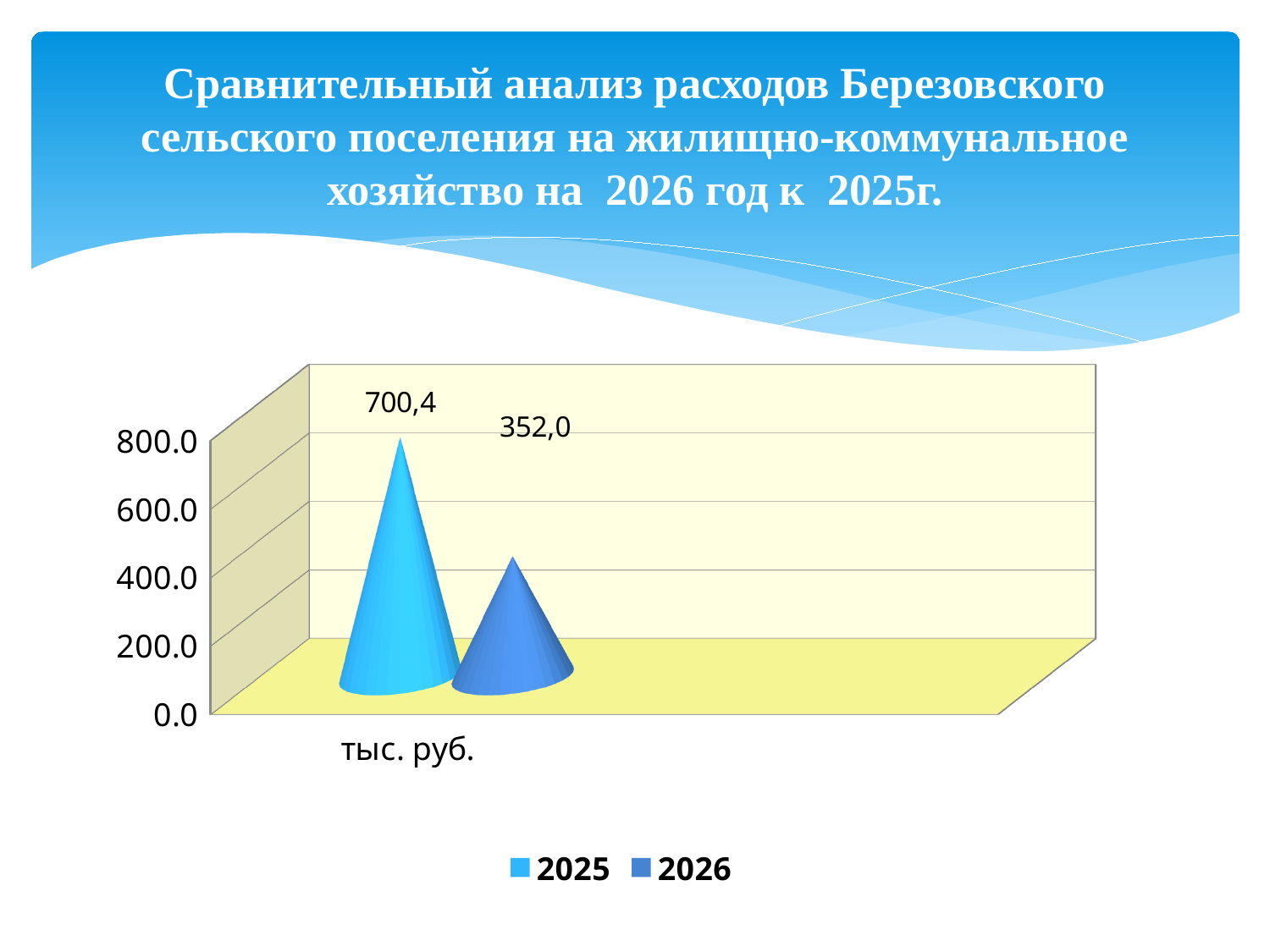
Which series has the higher value, 2025 or 2026? 2025 How many series does the legend list? 2 Is the value for 2025 greater or less than 600.0? greater What is the highest value shown on the vertical axis? 800.0 What is the value for 2025? 700,4 Which series has the highest value? 2025 Which series has the lowest value? 2026 What kind of chart is shown on the slide? bar chart What is the difference between the 2025 value and the 2026 value? 348,4 What is the value for 2026? 352,0 Is the value for 2026 greater or less than 400.0? less What is the category label shown on the x axis? тыс. руб.